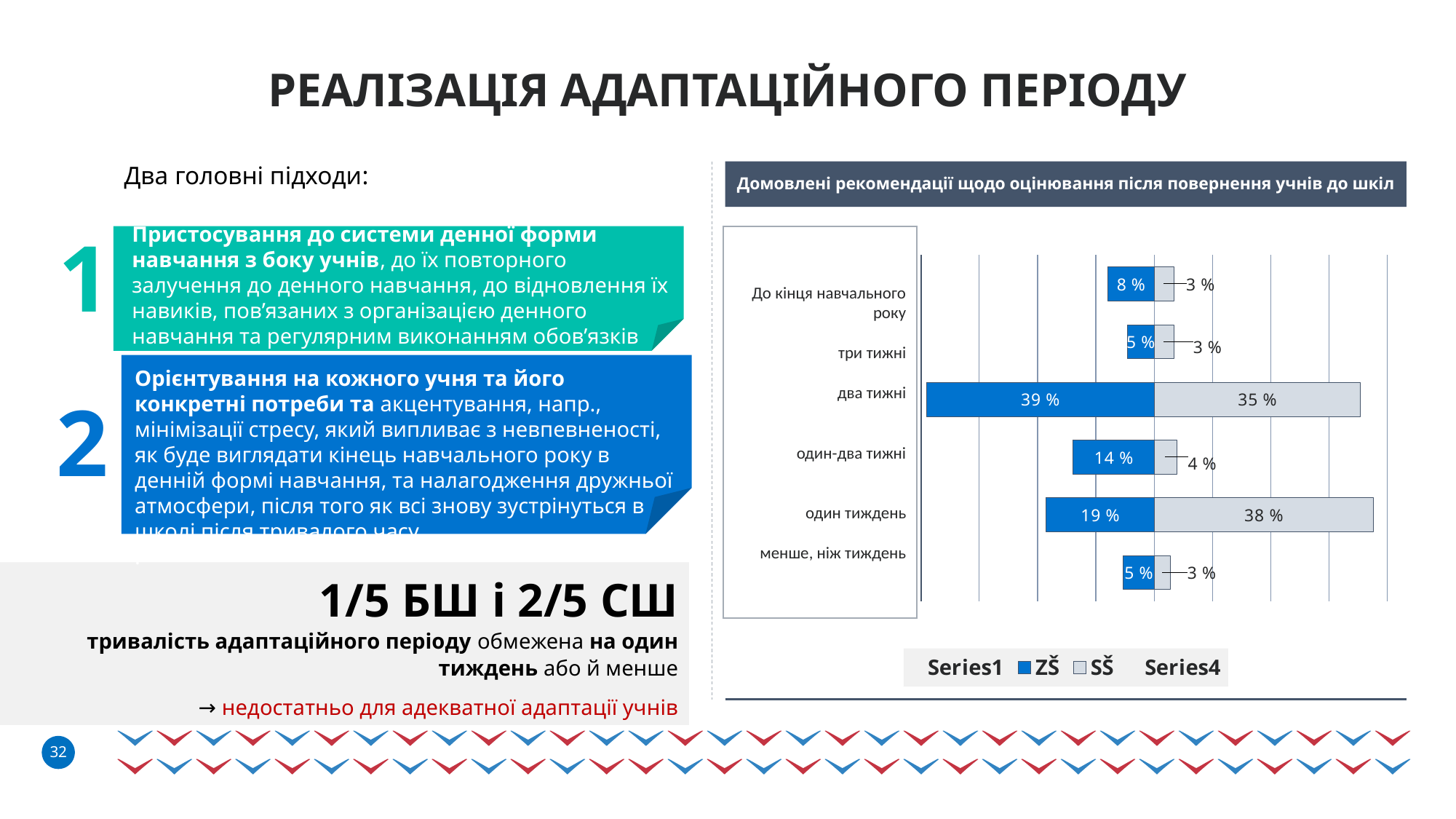
Which is larger for "один-два тижні": the ZŠ value or the SŠ value? ZŠ What type of chart is shown on the slide? Bar chart Which category has the highest SŠ value? один тиждень What is the ZŠ value for "один-два тижні"? 14 % What is the SŠ value for "До кінця навчального року"? 3 % What is the ZŠ value for "два тижні"? 39 % What is the difference between the ZŠ and SŠ values for "один тиждень"? 19 % What is the SŠ value for "один тиждень"? 38 % How many entries does the chart legend list? 4 How many categories are shown on the chart? 6 What is the difference between the ZŠ values for "два тижні" and "один тиждень"? 20 % Which category has the highest ZŠ value? два тижні